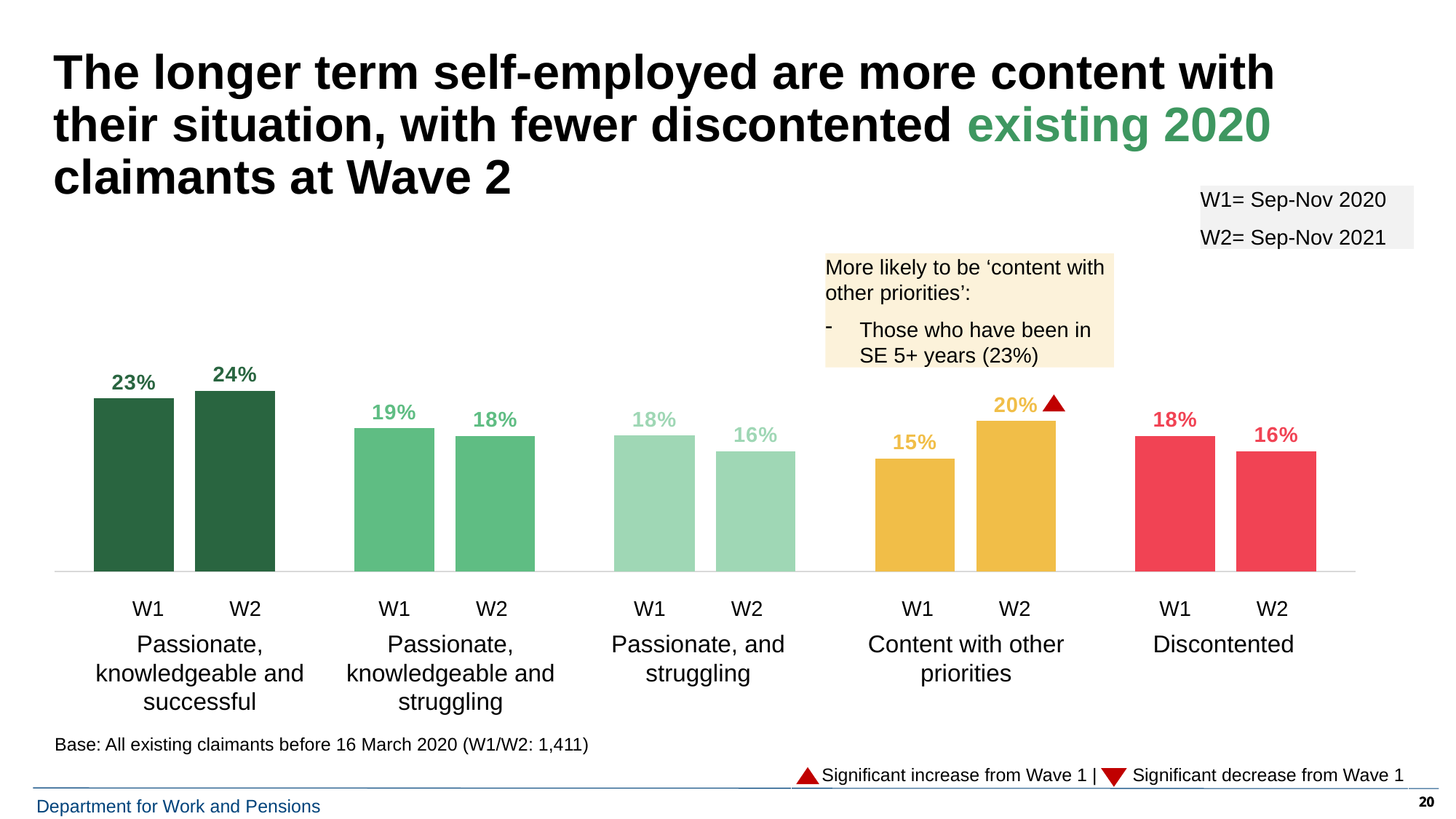
Which category is marked with a red triangle indicating a significant increase from Wave 1? Content with other priorities Which category has the highest W2 value? Passionate, knowledgeable and successful Which category has the lowest W1 value? Content with other priorities Which is larger for 'Discontented': the W1 value or the W2 value? W1 What is the W2 value for 'Passionate, knowledgeable and successful'? 24% What is the difference between the W1 and W2 values for 'Content with other priorities'? 5 percentage points What is the W1 value for 'Content with other priorities'? 15% How many categories are shown on the x axis of the chart? 5 What kind of chart is shown on the slide? Bar chart What is the W2 value for 'Discontented'? 16% What is the W1 value for 'Passionate, and struggling'? 18% According to the slide, what period does W2 cover? Sep-Nov 2021